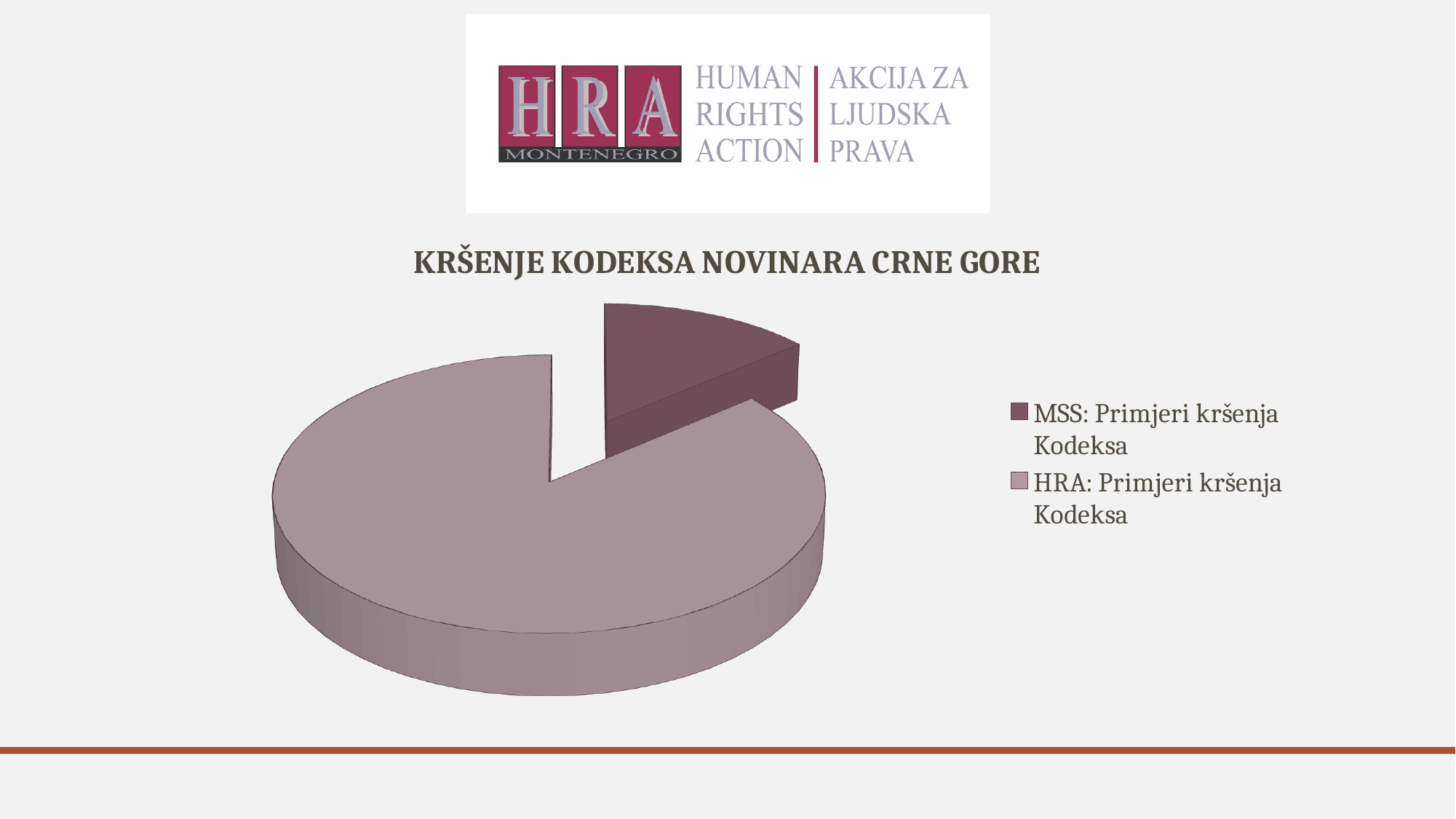
What kind of chart is shown on the slide? pie chart Which slice is the smallest in the pie chart? MSS: Primjeri kršenja Kodeksa Which legend entry is shown in the darker colour? MSS: Primjeri kršenja Kodeksa Which slice is the largest in the pie chart? HRA: Primjeri kršenja Kodeksa How many entries does the legend list? 2 What is the title of the chart? KRŠENJE KODEKSA NOVINARA CRNE GORE How many slices does the pie chart have? 2 Which is larger, the slice for MSS: Primjeri kršenja Kodeksa or the slice for HRA: Primjeri kršenja Kodeksa? HRA: Primjeri kršenja Kodeksa